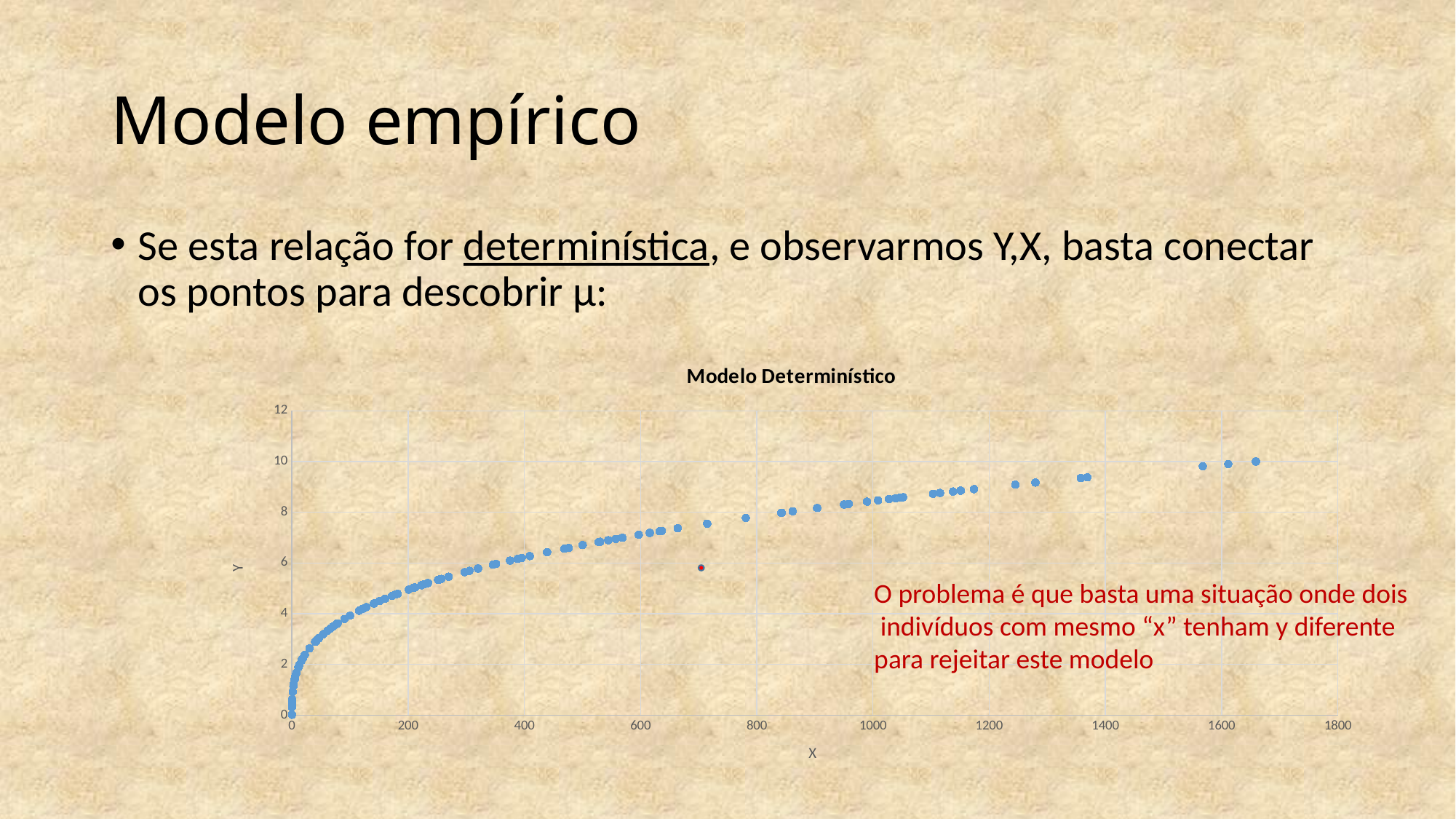
Is the Y value of the point near X = 1000 greater or less than 6? greater What is the label of the horizontal axis of the chart? X Is the Y value of the point near X = 400 greater or less than 4? greater Do the Y values rise or fall as X increases along the horizontal axis? Rise Is the Y value of the point near X = 800 greater or less than 10? less Which point has a higher Y value: the one near X = 1600 or the one near X = 200? The one near X = 1600 What is the highest tick value shown on the vertical axis? 12 What kind of chart is shown on the slide? Scatter chart What is the highest tick value shown on the horizontal axis? 1800 What is the title of the chart? Modelo Determinístico